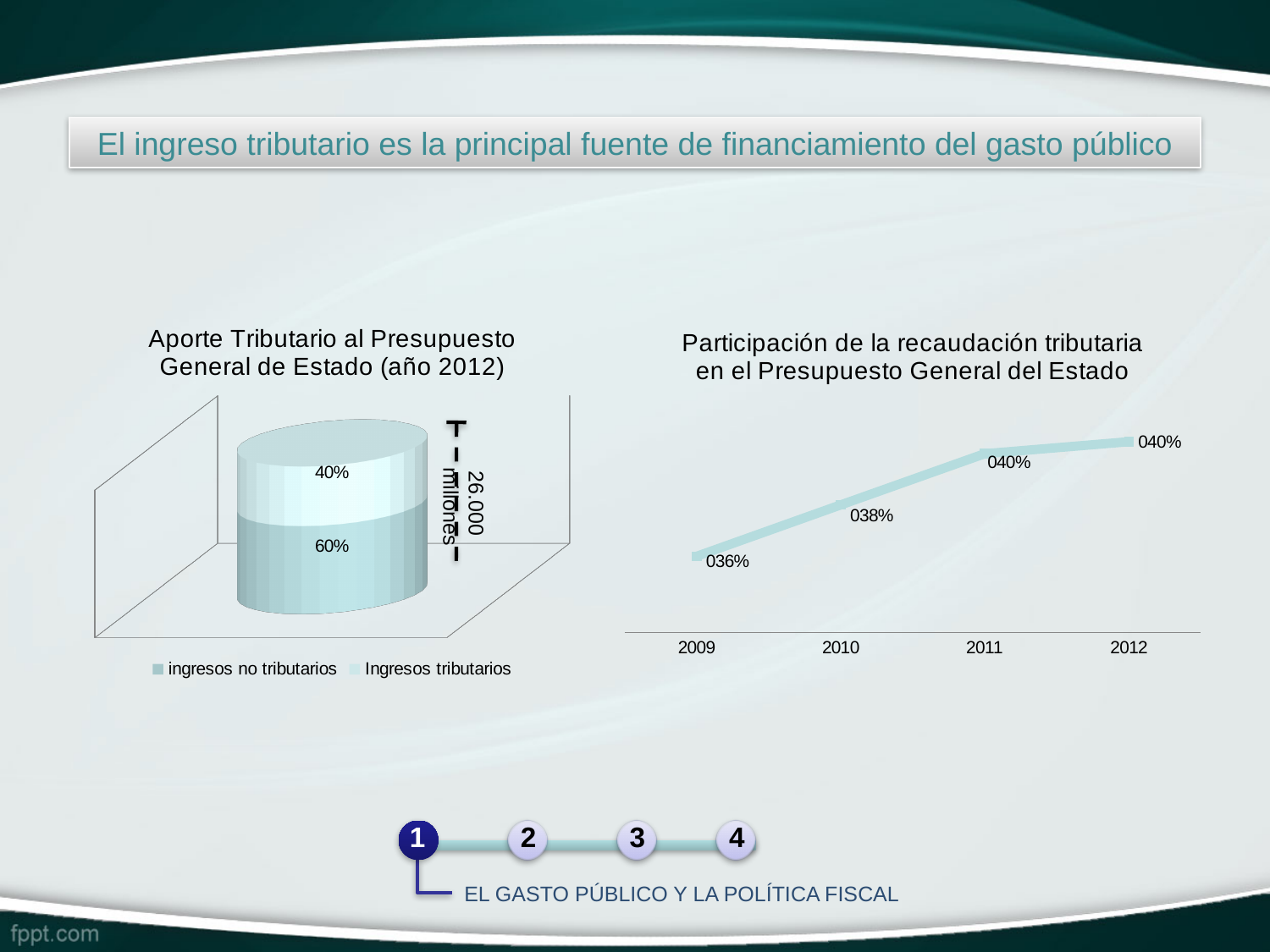
In the chart 'Participación de la recaudación tributaria en el Presupuesto General del Estado', what is the value for 2010? 038% In the chart 'Aporte Tributario al Presupuesto General de Estado (año 2012)', what is the total of the two stacked segments? 100% In the chart 'Participación de la recaudación tributaria en el Presupuesto General del Estado', what is the value for 2011? 040% How many years are plotted in the chart 'Participación de la recaudación tributaria en el Presupuesto General del Estado'? 4 In the chart 'Aporte Tributario al Presupuesto General de Estado (año 2012)', what is the difference between the two stacked segment values? 20% In the chart 'Participación de la recaudación tributaria en el Presupuesto General del Estado', what is the difference between the values for 2011 and 2009? 4% In the chart 'Participación de la recaudación tributaria en el Presupuesto General del Estado', which year has the lowest value? 2009 How many series does the legend of the chart 'Aporte Tributario al Presupuesto General de Estado (año 2012)' list? 2 In the chart 'Participación de la recaudación tributaria en el Presupuesto General del Estado', do the values rise or fall from 2009 to 2012? rise In the chart 'Participación de la recaudación tributaria en el Presupuesto General del Estado', what is the value for 2009? 036% In the chart 'Participación de la recaudación tributaria en el Presupuesto General del Estado', which is larger, the value for 2010 or the value for 2012? 2012 What kind of chart is 'Participación de la recaudación tributaria en el Presupuesto General del Estado'? line chart